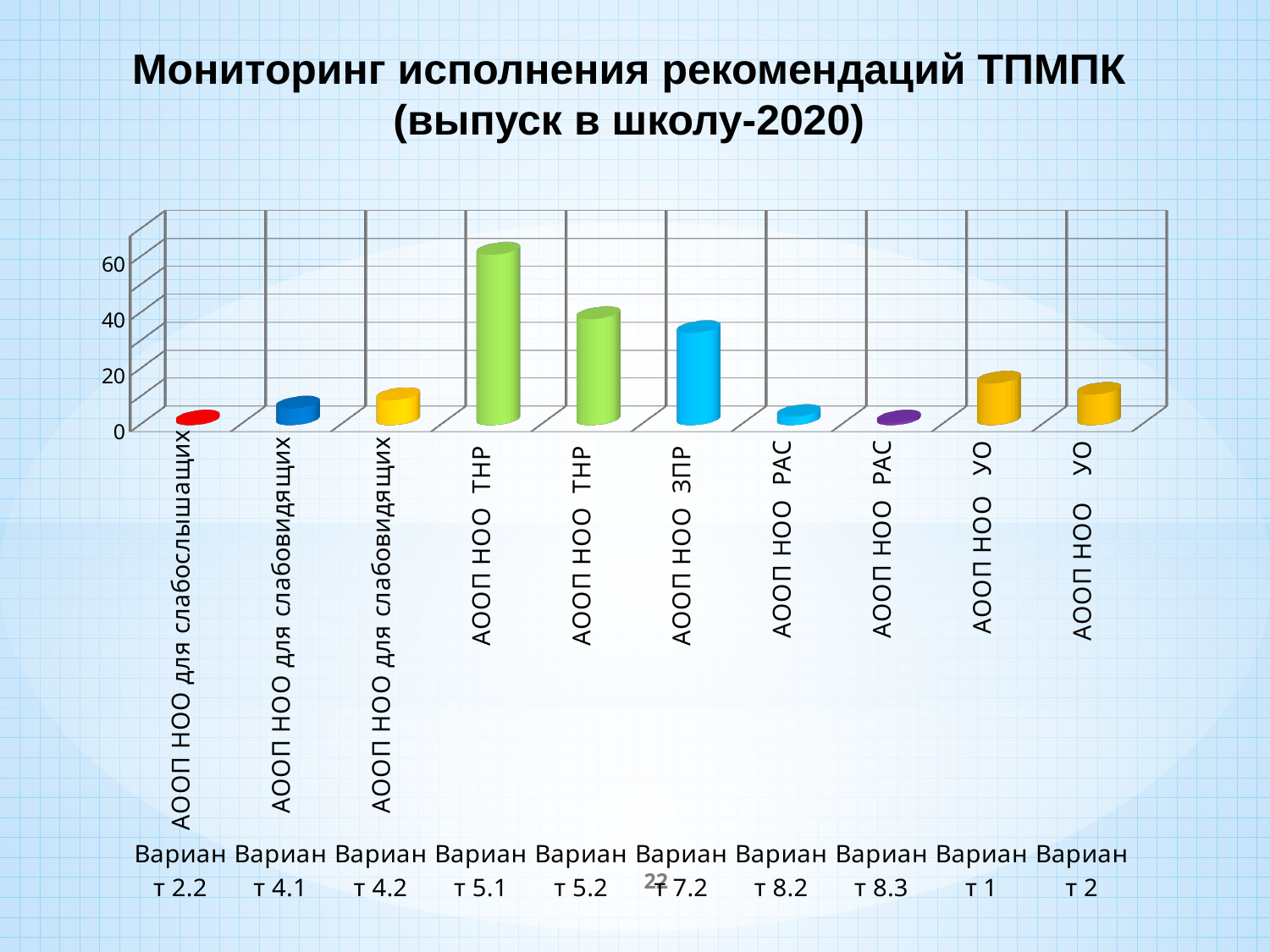
What colour are the bars for the two АООП НОО ТНР categories? green Is the value for АООП НОО РАС (Вариант 8.2) greater or less than 20? less What is the title of the slide containing the chart? Мониторинг исполнения рекомендаций ТПМПК (выпуск в школу-2020) Is the value for АООП НОО ТНР (Вариант 5.2) greater or less than 20? greater Is the value for АООП НОО УО (Вариант 1) greater or less than 20? less Which is larger: the value for АООП НОО ЗПР (Вариант 7.2) or АООП НОО УО (Вариант 1)? АООП НОО ЗПР (Вариант 7.2) How many categories are plotted in the chart? 10 Which category has the highest bar in the chart? АООП НОО ТНР (Вариант 5.1) Which is larger: the value for АООП НОО ТНР (Вариант 5.1) or АООП НОО ТНР (Вариант 5.2)? АООП НОО ТНР (Вариант 5.1) What kind of chart is shown on the slide? bar chart